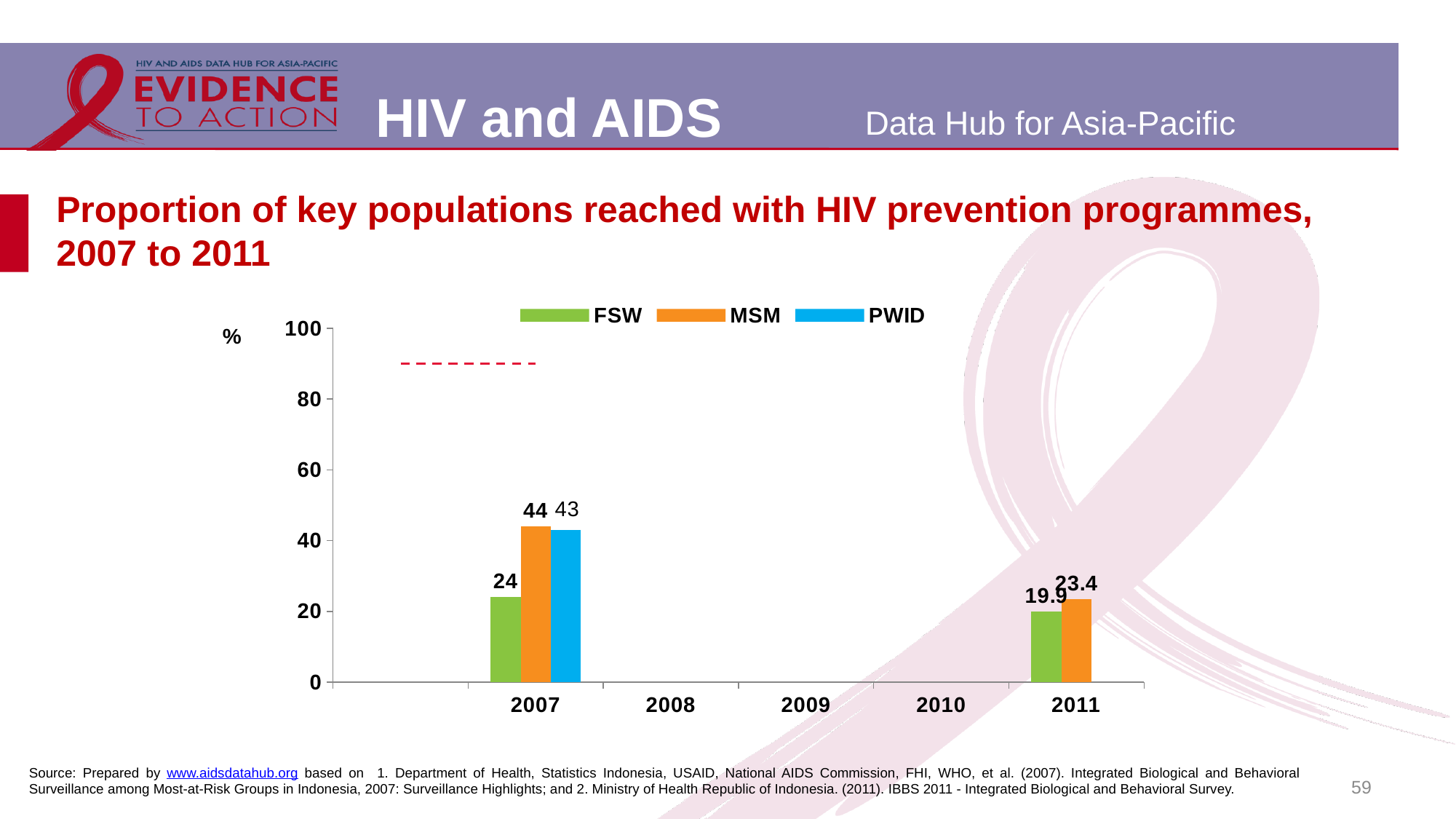
Which key population has the highest value in 2007? MSM What is the value for FSW in 2007? 24 What is the value for PWID in 2007? 43 What is the difference between the MSM and FSW values in 2007? 20 What is the value for FSW in 2011? 19.9 What kind of chart is shown on the slide? Bar chart Which key population has the lowest value in 2007? FSW What is the value for MSM in 2007? 44 Which is larger, the MSM value in 2007 or the MSM value in 2011? MSM in 2007 How many series does the legend list? 3 How many years are shown on the x axis? 5 What is the value for MSM in 2011? 23.4